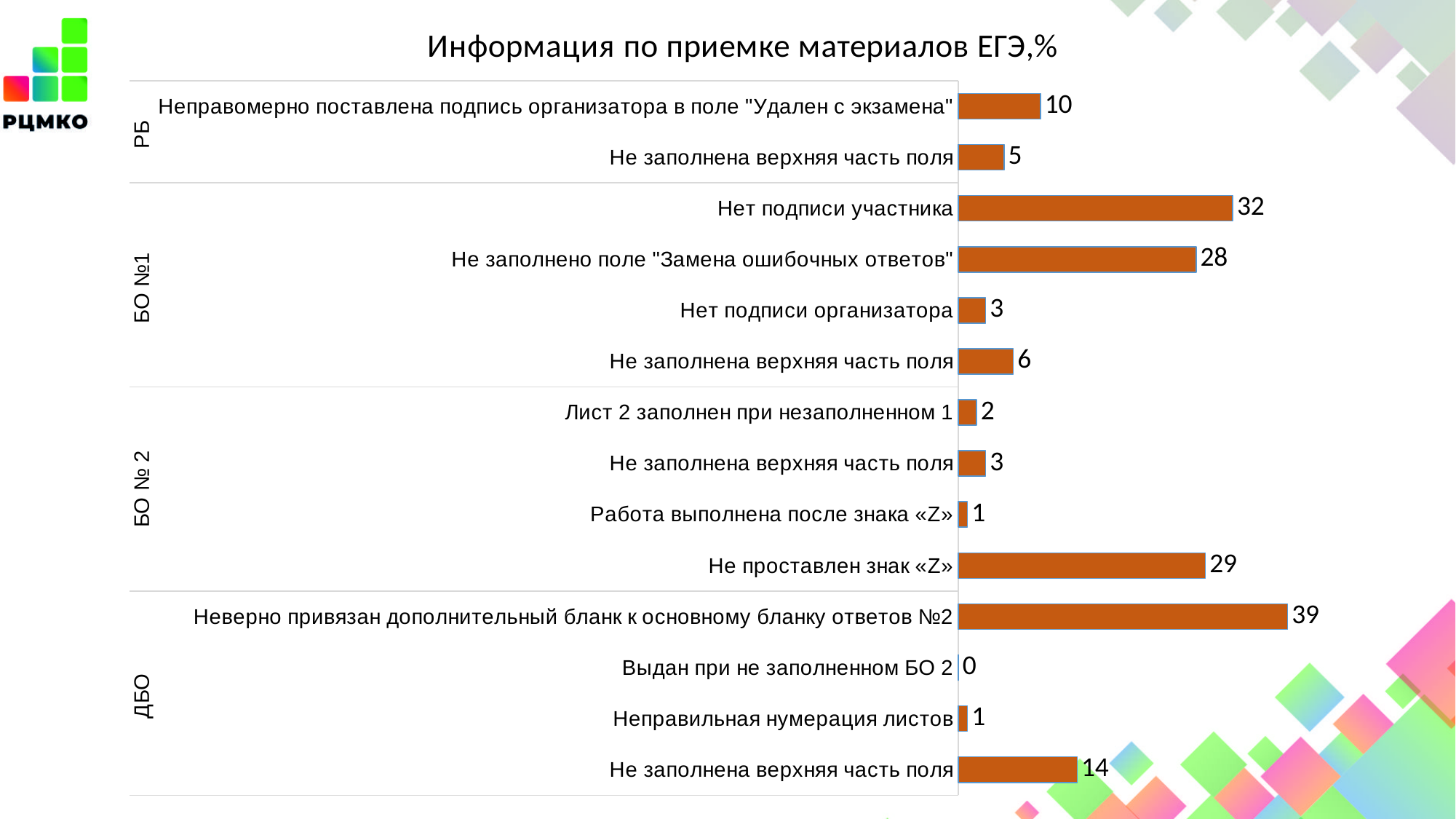
Which is larger: "Не проставлен знак «Z»" or "Не заполнена верхняя часть поля" in the РБ group? Не проставлен знак «Z» How many category groups (РБ, БО №1, БО № 2, ДБО) are shown on the vertical axis? 4 What is the value for "Неверно привязан дополнительный бланк к основному бланку ответов №2" in the ДБО group? 39 What is the value for "Нет подписи участника" in the БО №1 group? 32 What is the title of the chart? Информация по приемке материалов ЕГЭ,% Which category has the lowest value in the chart? Выдан при не заполненном БО 2 What is the value for "Не заполнена верхняя часть поля" in the ДБО group? 14 How many bars are plotted in the chart? 14 What type of chart is shown on the slide? bar chart What is the difference between "Нет подписи участника" (32) and "Не заполнено поле "Замена ошибочных ответов"" (28)? 4 Which category has the highest value in the chart? Неверно привязан дополнительный бланк к основному бланку ответов №2 What is the value for "Выдан при не заполненном БО 2"? 0